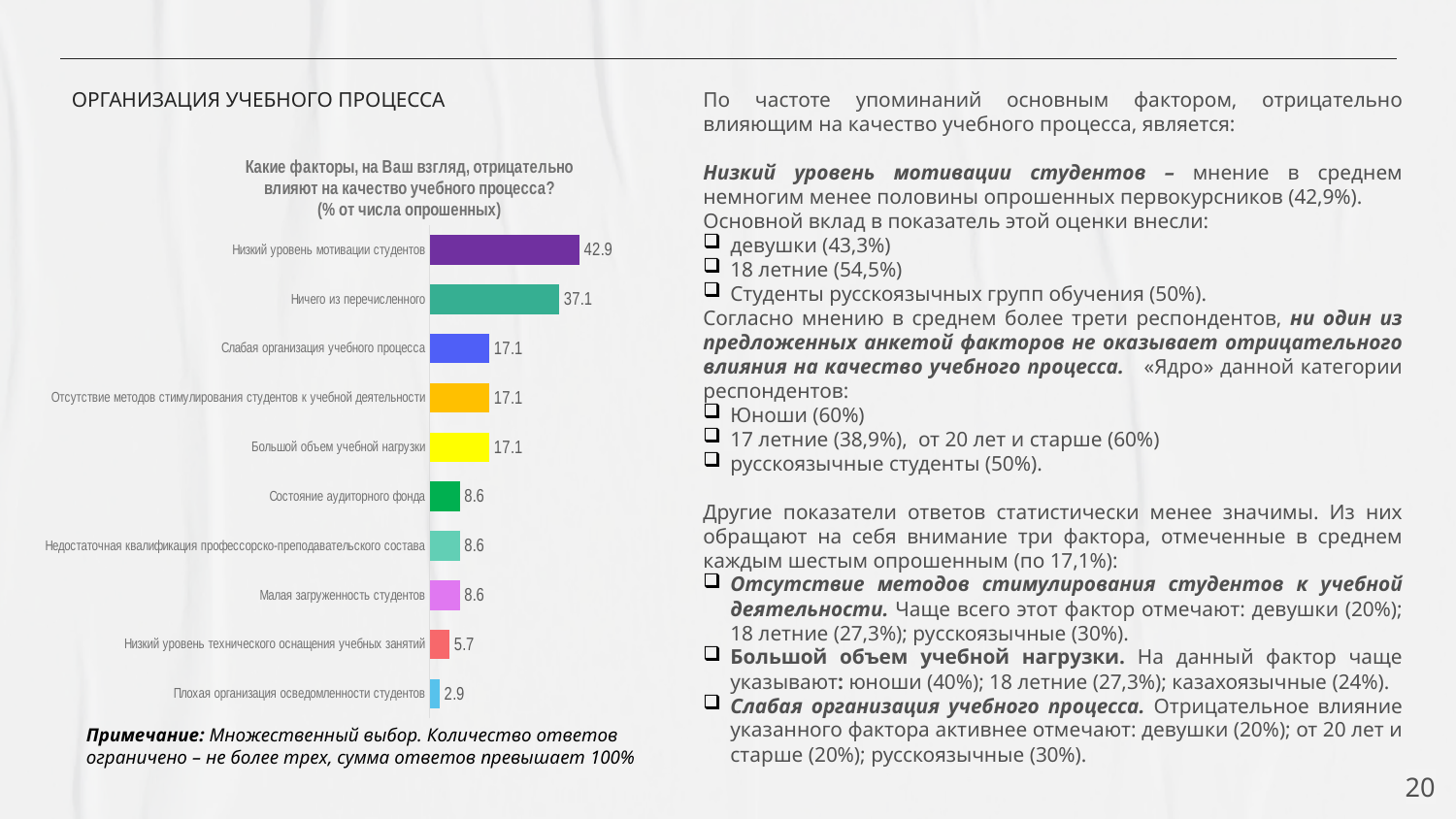
What value is shown for "Состояние аудиторного фонда"? 8.6 What value is shown for "Низкий уровень мотивации студентов"? 42.9 What value is shown for "Плохая организация осведомленности студентов"? 2.9 How many categories share the value 17.1? 3 Which category has the highest value? Низкий уровень мотивации студентов Which is larger: the value for "Большой объем учебной нагрузки" or the value for "Малая загруженность студентов"? Большой объем учебной нагрузки What is the difference between the values for "Низкий уровень мотивации студентов" and "Ничего из перечисленного"? 5.8 What value is shown for "Ничего из перечисленного"? 37.1 What is the difference between the values for "Низкий уровень технического оснащения учебных занятий" and "Плохая организация осведомленности студентов"? 2.8 Which category has the lowest value? Плохая организация осведомленности студентов What kind of chart is shown on the slide? Bar chart How many categories are shown in the chart? 10